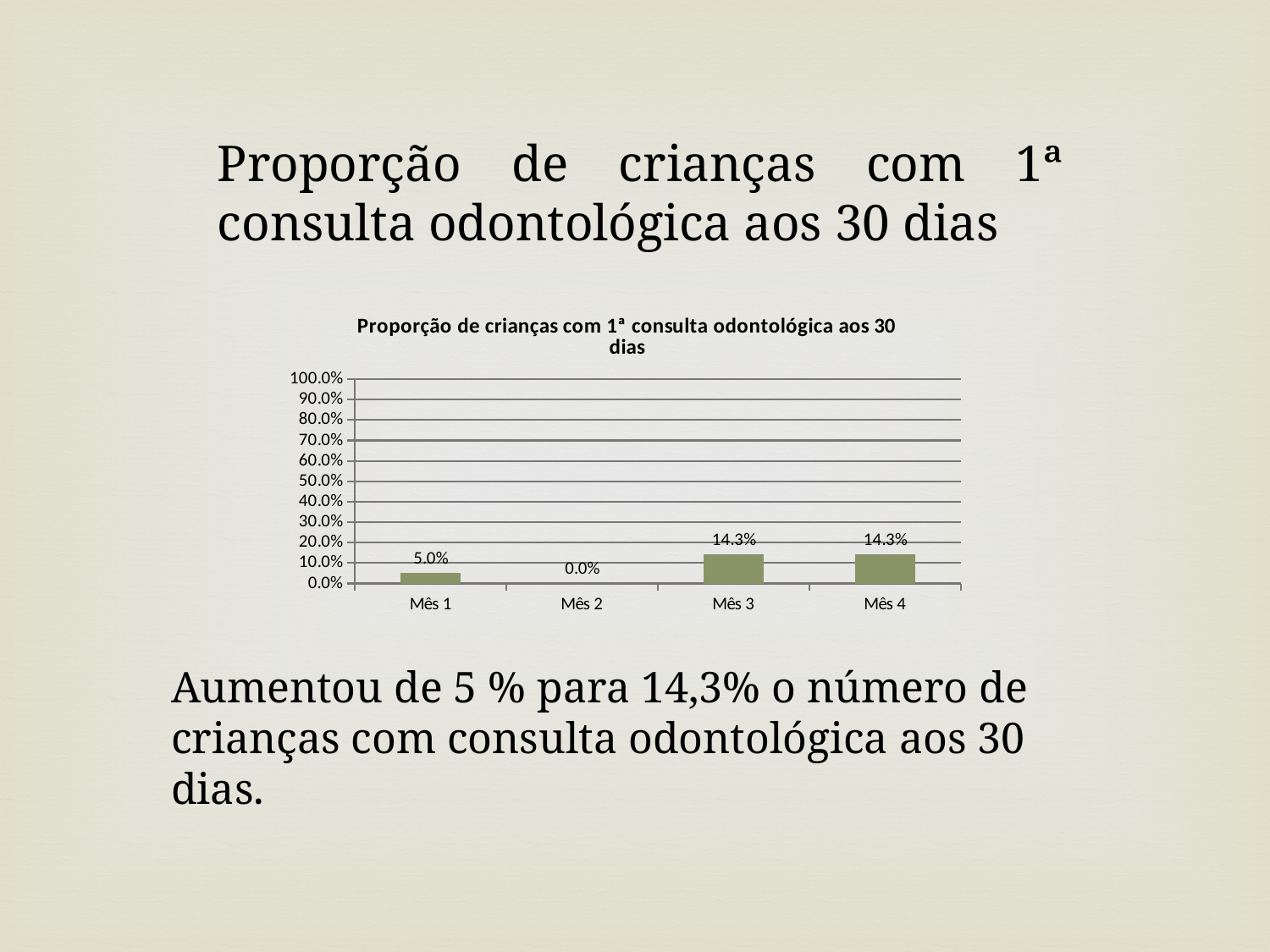
Is the value for Mês 4 greater or less than 20%? less What is the maximum value shown on the y axis? 100.0% How many categories are shown on the x axis? 4 What is the difference between the values for Mês 3 and Mês 1? 9.3% What is the title of the chart? Proporção de crianças com 1ª consulta odontológica aos 30 dias What is the value for Mês 4? 14.3% What is the value for Mês 1? 5.0% What is the value for Mês 3? 14.3% What kind of chart is shown on the slide? bar chart Which is larger, the value for Mês 1 or the value for Mês 3? Mês 3 What is the value for Mês 2? 0.0% Which category has the lowest value? Mês 2